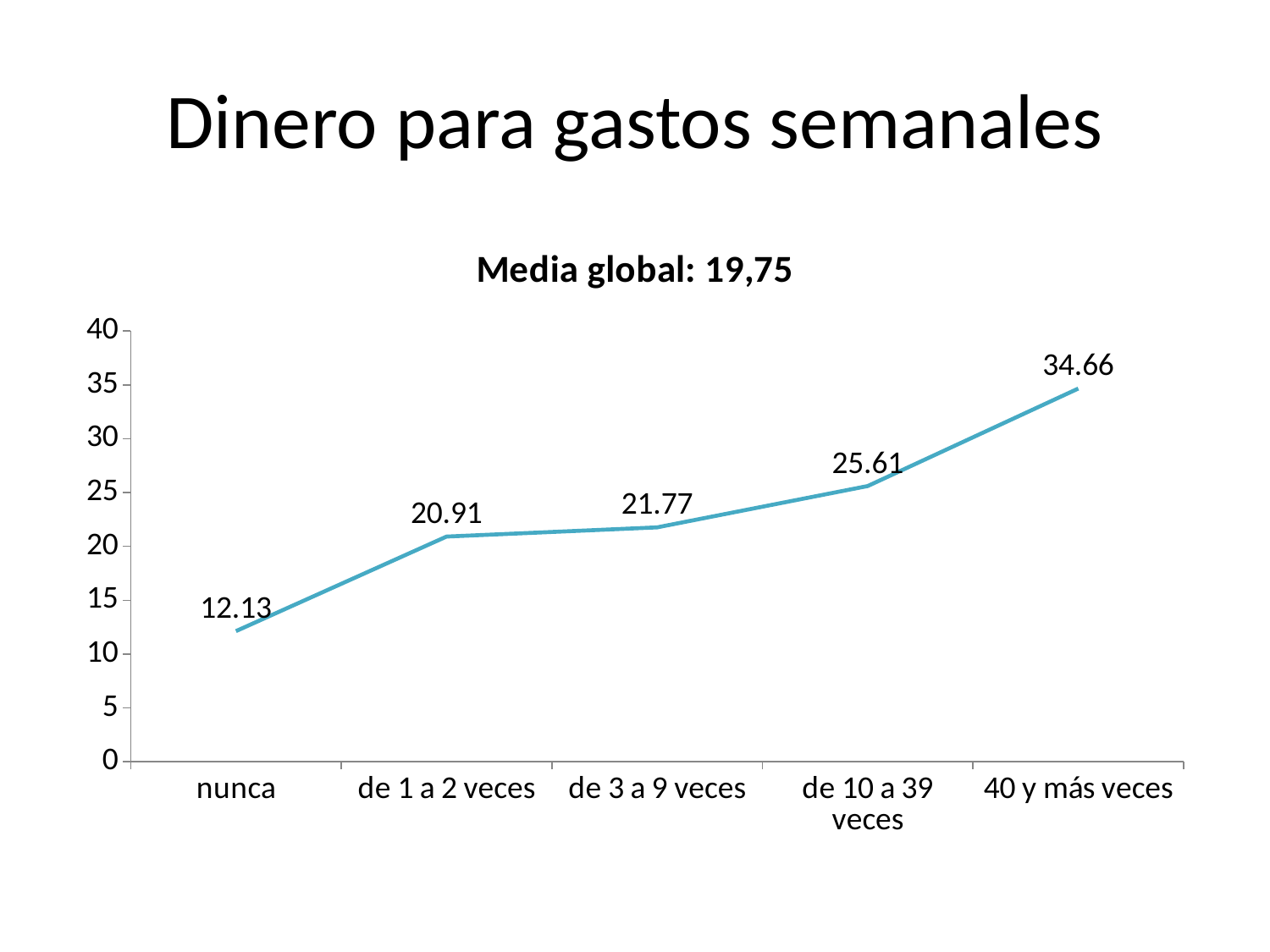
What kind of chart is shown on the slide? line chart What is the value for "nunca"? 12.13 What is the value for "de 3 a 9 veces"? 21.77 What is the value for "de 1 a 2 veces"? 20.91 Which is larger, the value for "de 10 a 39 veces" or the value for "de 1 a 2 veces"? de 10 a 39 veces What is the value for "40 y más veces"? 34.66 What is the difference between the values for "40 y más veces" and "nunca"? 22.53 What is the value for "de 10 a 39 veces"? 25.61 How many categories are shown on the x axis? 5 Which category has the highest value? 40 y más veces Which category has the lowest value? nunca Do the values rise or fall from left to right along the x axis? rise